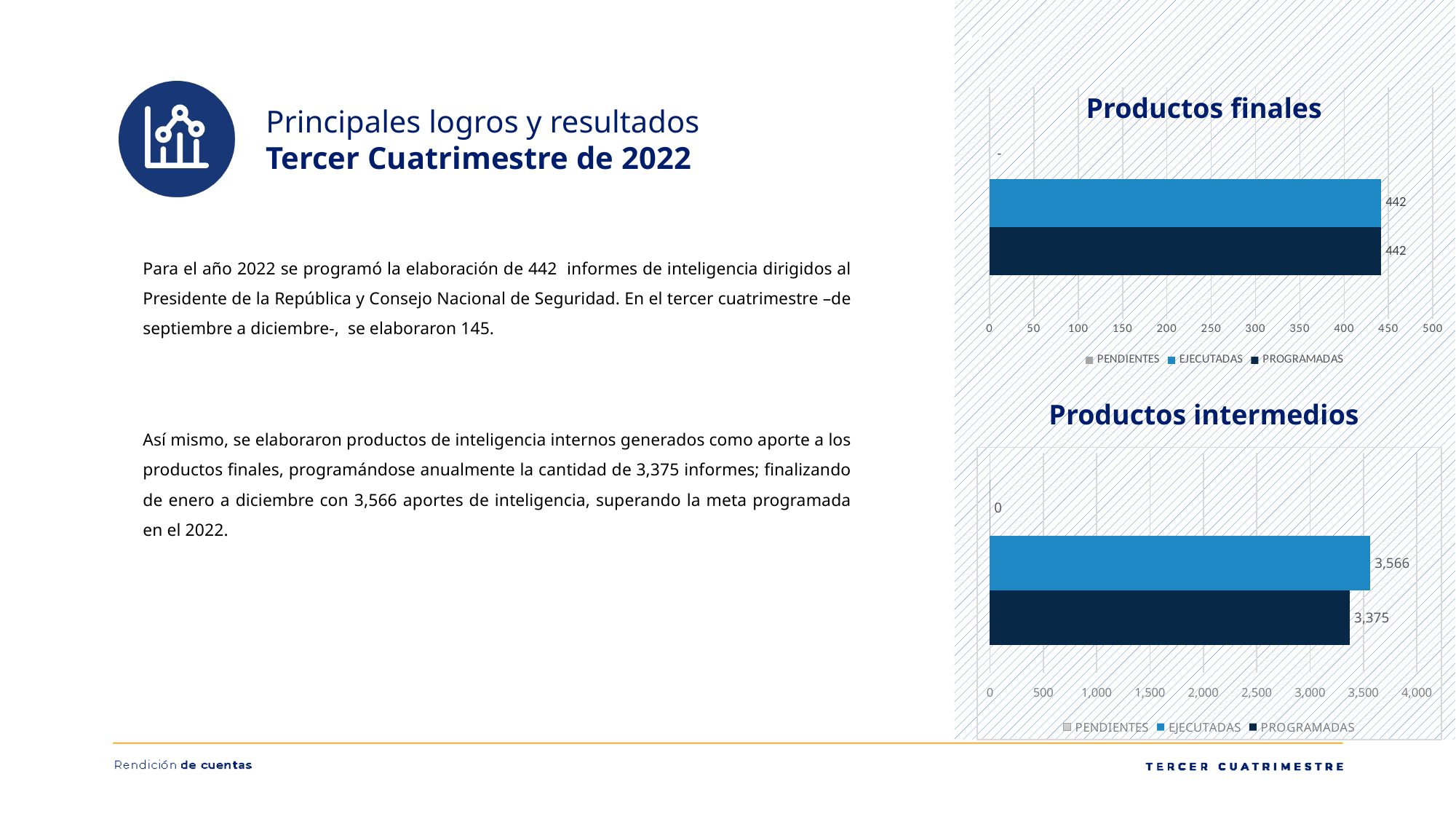
In the 'Productos intermedios' chart, what is the value for PENDIENTES? 0 In the 'Productos intermedios' chart, what is the value for EJECUTADAS? 3,566 What kind of chart is the 'Productos finales' chart? Bar chart In the 'Productos finales' chart, is the value for EJECUTADAS greater or less than 400? greater In the 'Productos intermedios' chart, what is the difference between EJECUTADAS and PROGRAMADAS? 191 How many series does the legend of the 'Productos intermedios' chart list? 3 In the 'Productos finales' chart, what is the difference between EJECUTADAS and PROGRAMADAS? 0 In the 'Productos intermedios' chart, which is larger, EJECUTADAS or PROGRAMADAS? EJECUTADAS In the 'Productos finales' chart, what is the value for EJECUTADAS? 442 In the 'Productos finales' chart, what is the value for PROGRAMADAS? 442 In the 'Productos intermedios' chart, is the value for PROGRAMADAS greater or less than 3,500? less In the 'Productos intermedios' chart, what is the value for PROGRAMADAS? 3,375